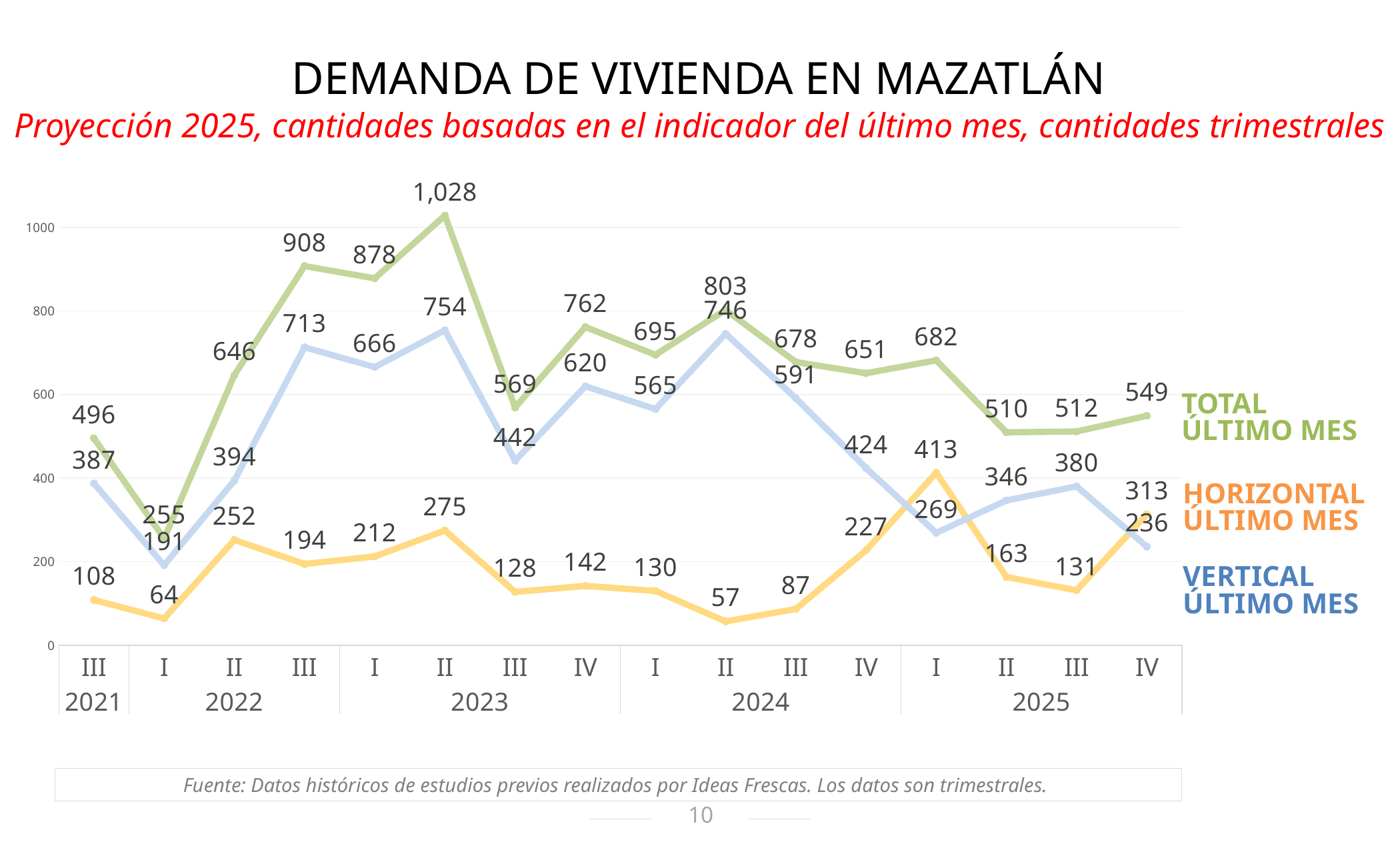
What is the difference between TOTAL ÚLTIMO MES and VERTICAL ÚLTIMO MES in quarter II of 2024? 57 In which quarter is HORIZONTAL ÚLTIMO MES at its lowest? II 2024 Does TOTAL ÚLTIMO MES rise or fall from quarter I of 2025 to quarter II of 2025? Fall How many series does the chart show? 3 What is the value of VERTICAL ÚLTIMO MES in quarter III of 2022? 713 Is the value of VERTICAL ÚLTIMO MES in quarter I of 2022 greater or less than 200? less What kind of chart is shown on the slide? Line chart How many quarters are plotted on the x axis? 16 What is the value of TOTAL ÚLTIMO MES in quarter II of 2023? 1,028 What is the value of HORIZONTAL ÚLTIMO MES in quarter I of 2025? 413 Which is larger in quarter I of 2025: HORIZONTAL ÚLTIMO MES or VERTICAL ÚLTIMO MES? HORIZONTAL ÚLTIMO MES In which quarter does TOTAL ÚLTIMO MES reach its highest value? II 2023